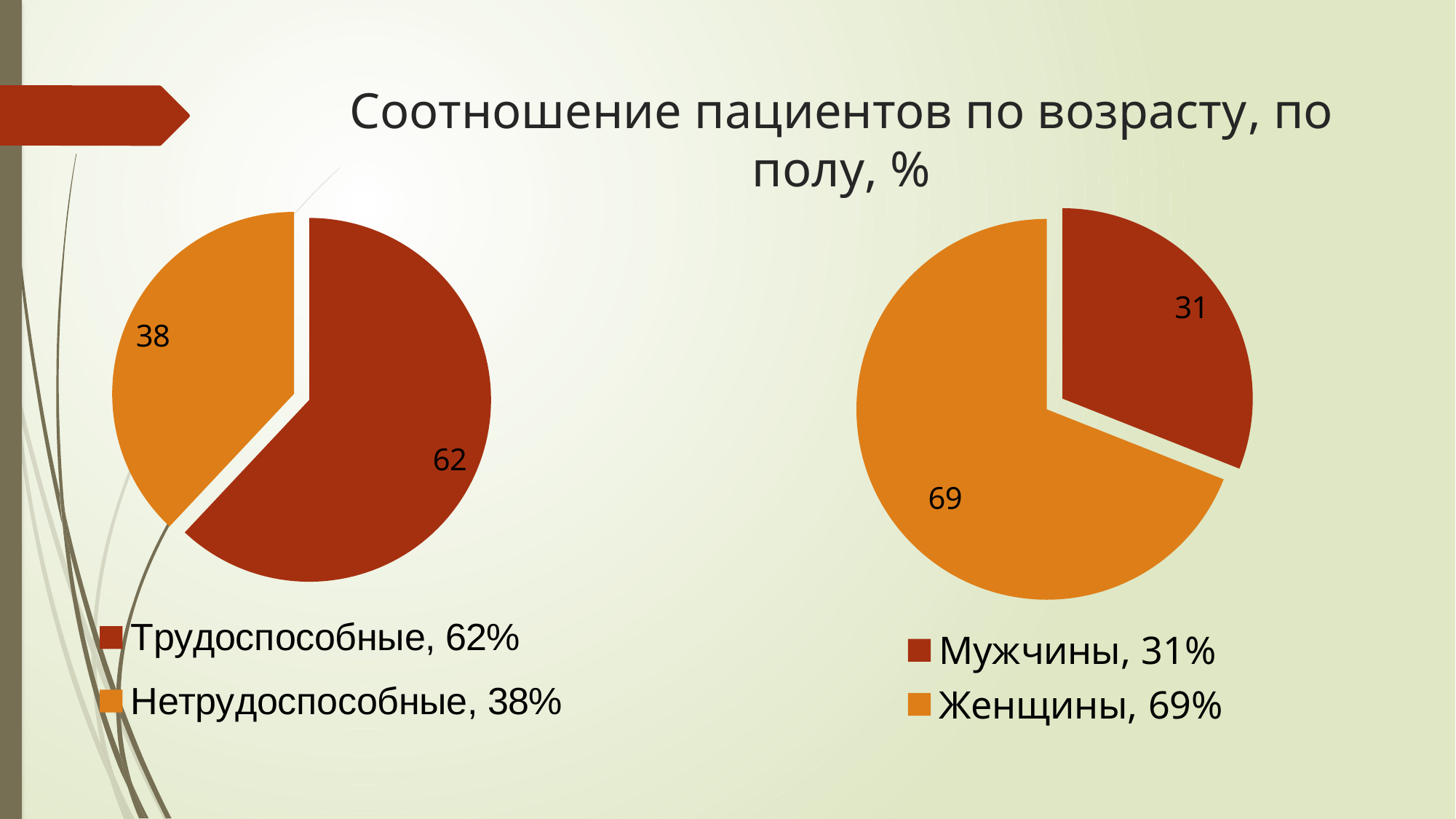
In the left pie chart, what is the difference between the values for Трудоспособные and Нетрудоспособные? 24 In the right pie chart, what is the value for Мужчины? 31 In the left pie chart, what is the value for Нетрудоспособные? 38 In the right pie chart, which is larger, Мужчины or Женщины? Женщины In the right pie chart, which category has the smallest slice? Мужчины In the right pie chart, what is the value for Женщины? 69 In the right pie chart, what is the difference between the values for Женщины and Мужчины? 38 What is the title of the slide's charts? Соотношение пациентов по возрасту, по полу, % How many slices does the left pie chart have? 2 In the left pie chart, which category has the largest slice? Трудоспособные What type of chart is the right chart? Pie chart In the left pie chart, what is the value for Трудоспособные? 62